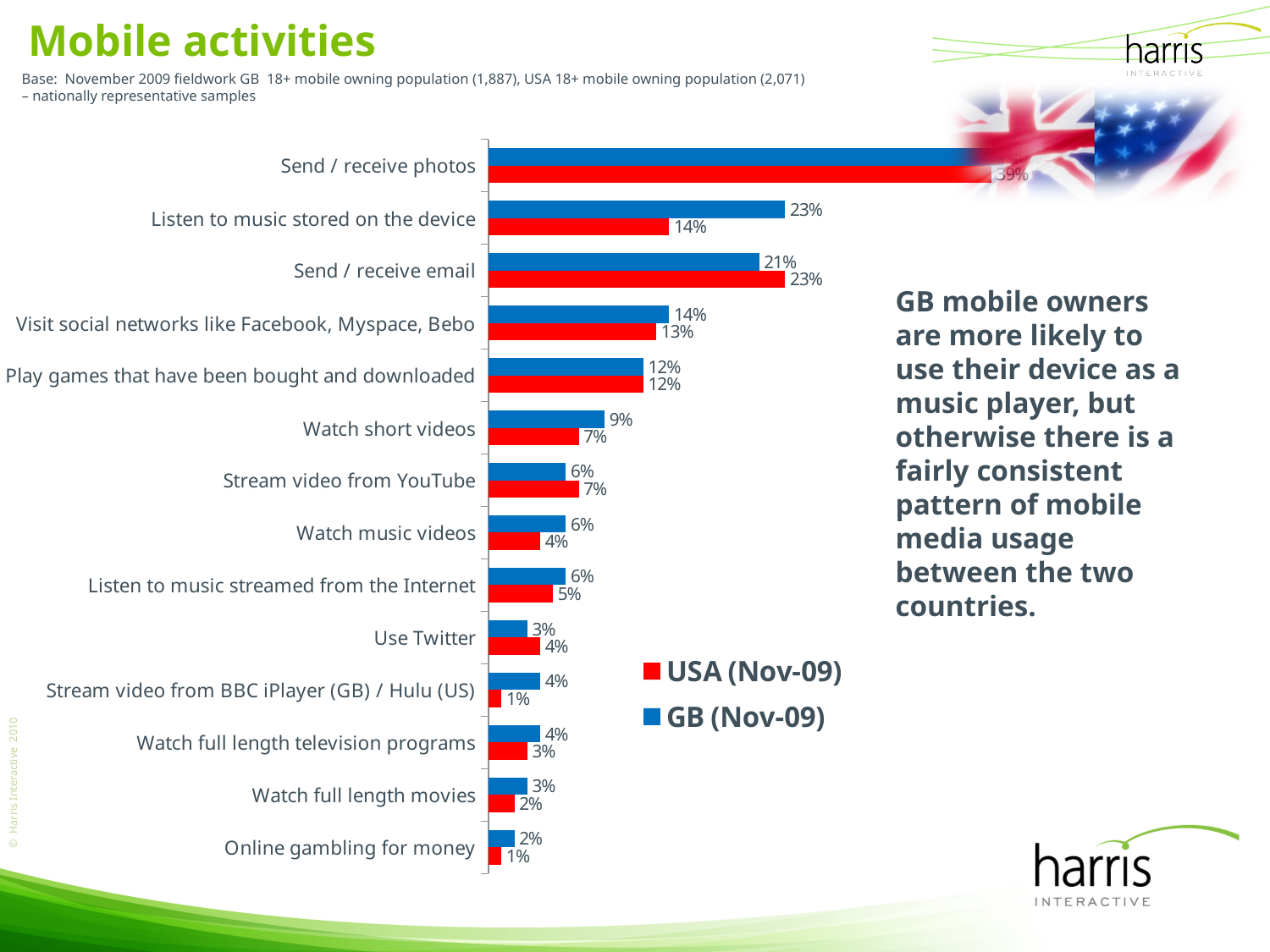
What is the GB (Nov-09) value for 'Listen to music stored on the device'? 23% What is the USA (Nov-09) value for 'Play games that have been bought and downloaded'? 12% Which activity has the highest GB (Nov-09) value? Send / receive photos What is the difference between the GB (Nov-09) and USA (Nov-09) values for 'Listen to music stored on the device'? 9% How many series does the legend list? 2 For 'Watch music videos', which is larger: the GB (Nov-09) value or the USA (Nov-09) value? GB (Nov-09) What is the USA (Nov-09) value for 'Send / receive email'? 23% How many activities (categories) are shown on the chart? 14 What is the USA (Nov-09) value for 'Stream video from BBC iPlayer (GB) / Hulu (US)'? 1% Which activity has the lowest GB (Nov-09) value? Online gambling for money What kind of chart is shown on the slide? Bar chart Which colour represents the USA (Nov-09) series in the chart? Red